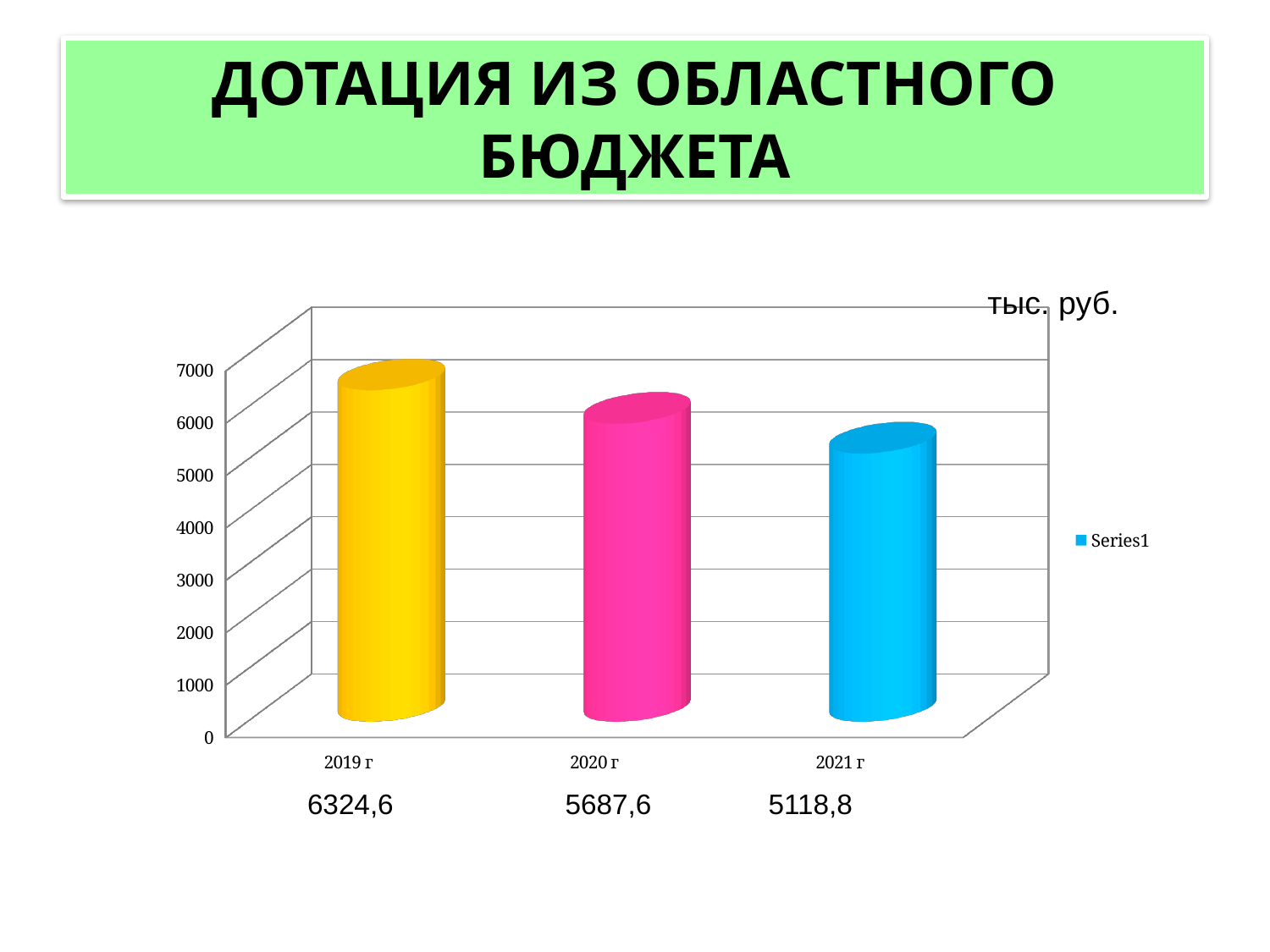
Is the value for 2021 г greater or less than 6000? less What is the difference between the values for 2019 г and 2020 г? 637,0 How many years are shown on the chart? 3 Which year has the highest value? 2019 г What is the value for 2019 г? 6324,6 What kind of chart is shown on the slide? bar chart Do the values rise or fall from 2019 г to 2021 г? fall What is the value for 2021 г? 5118,8 What is the value for 2020 г? 5687,6 What is the difference between the values for 2020 г and 2021 г? 568,8 Which year has the lowest value? 2021 г Which is larger, the value for 2020 г or the value for 2021 г? 2020 г